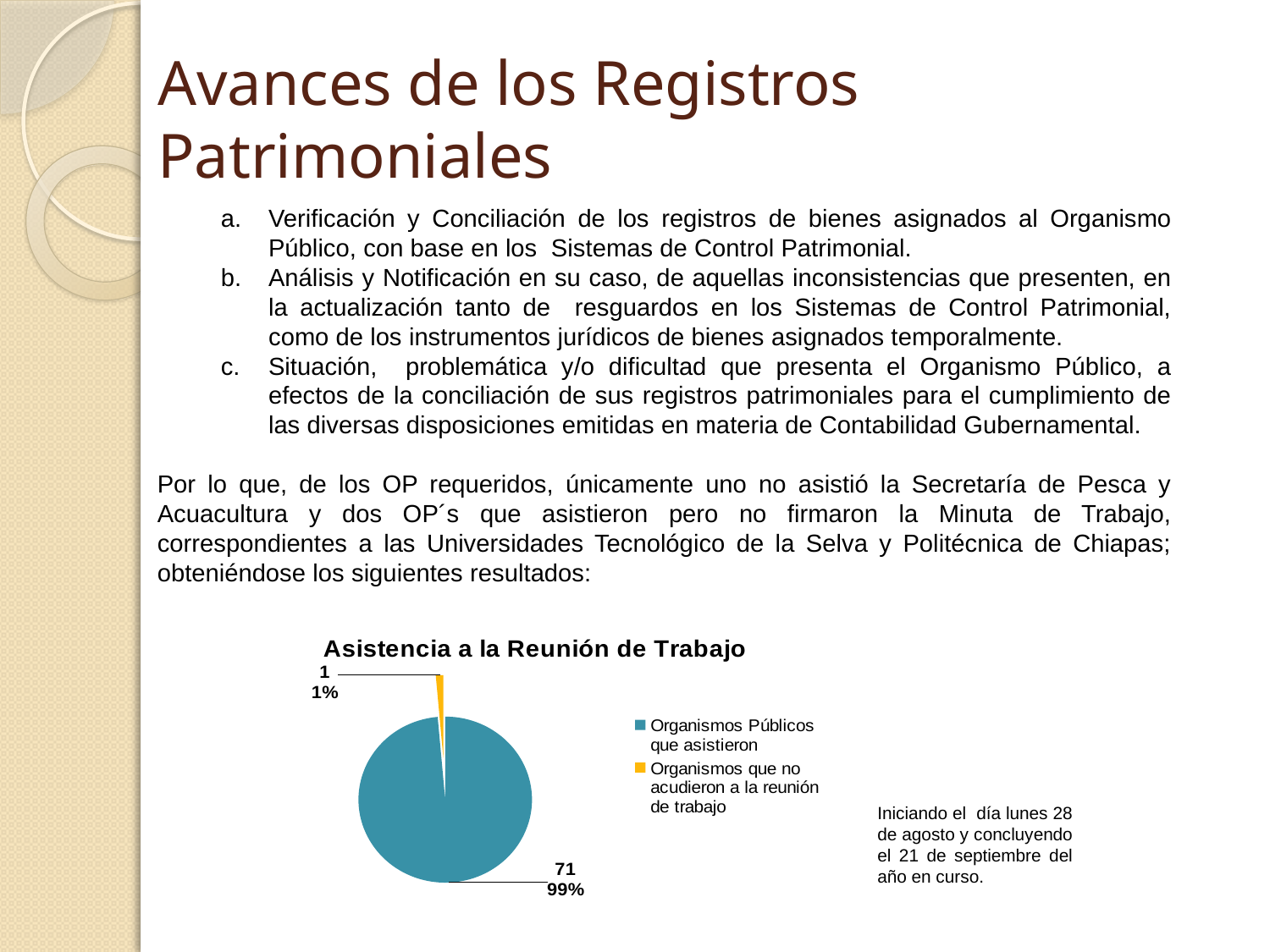
What share of the pie does 'Organismos que no acudieron a la reunión de trabajo' represent? 1% What is the title of the chart? Asistencia a la Reunión de Trabajo What is the value for 'Organismos Públicos que asistieron'? 71 What type of chart is shown on the slide? pie chart What share of the pie does 'Organismos Públicos que asistieron' represent? 99% How many slices does the pie chart have? 2 Which category has the smallest slice? Organismos que no acudieron a la reunión de trabajo What colour is the slice for 'Organismos que no acudieron a la reunión de trabajo'? yellow What is the difference between the number of organisms that attended and those that did not attend? 70 What is the value for 'Organismos que no acudieron a la reunión de trabajo'? 1 Which category has the largest slice? Organismos Públicos que asistieron How many entries does the legend list? 2